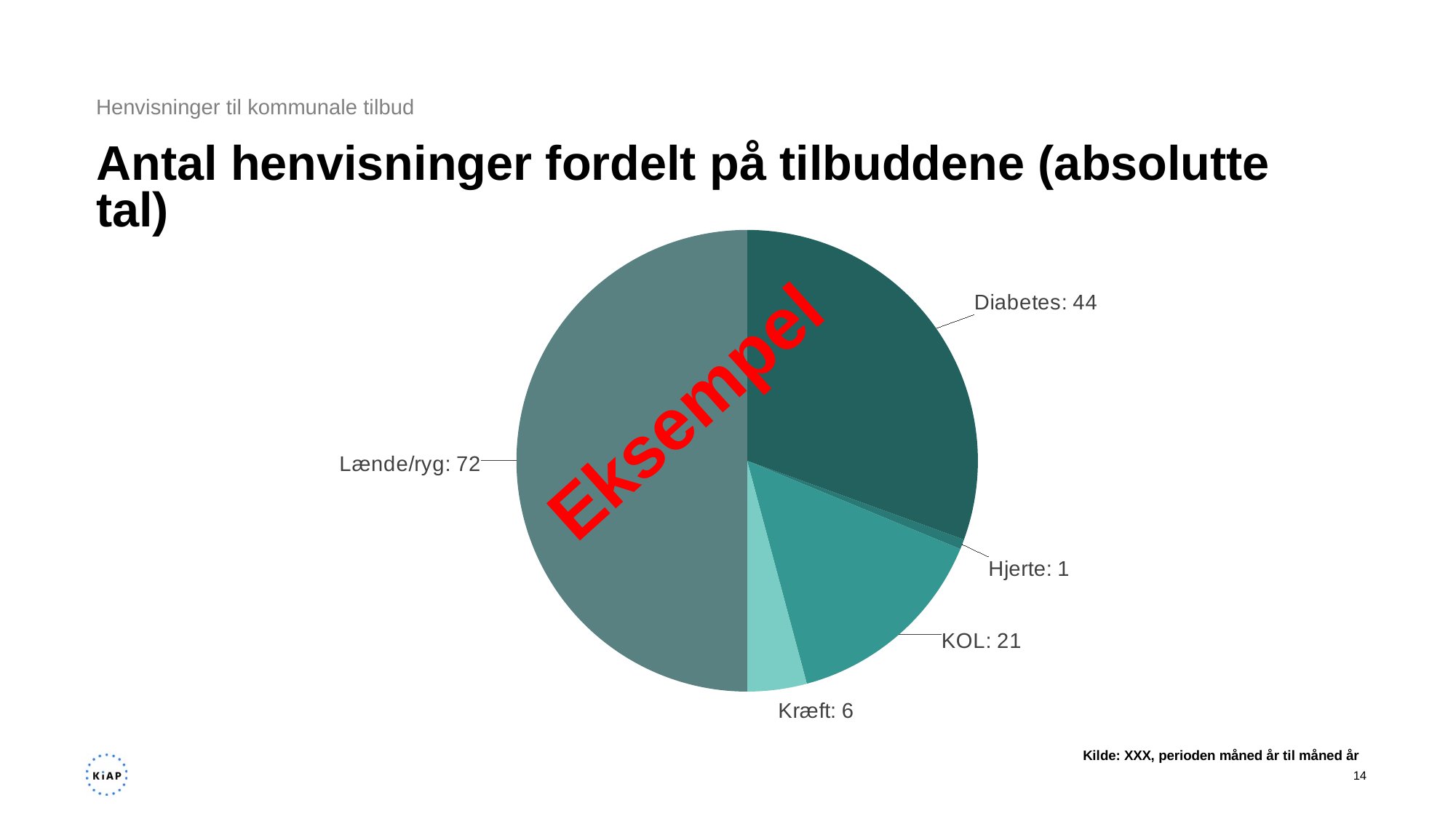
Which category has the smallest slice of the pie? Hjerte What share of the total does the Lænde/ryg slice represent? 50% What is the title of the chart on the slide? Antal henvisninger fordelt på tilbuddene (absolutte tal) What is the value for KOL? 21 How many referrals are shown for Diabetes? 44 What is the value for Hjerte? 1 What type of chart is shown on the slide? pie chart What is the difference between the values for Lænde/ryg and Diabetes? 28 How many categories are shown in the pie chart? 5 Which category has the largest slice of the pie? Lænde/ryg Which is larger, the value for KOL or the value for Kræft? KOL What is the value for Kræft? 6